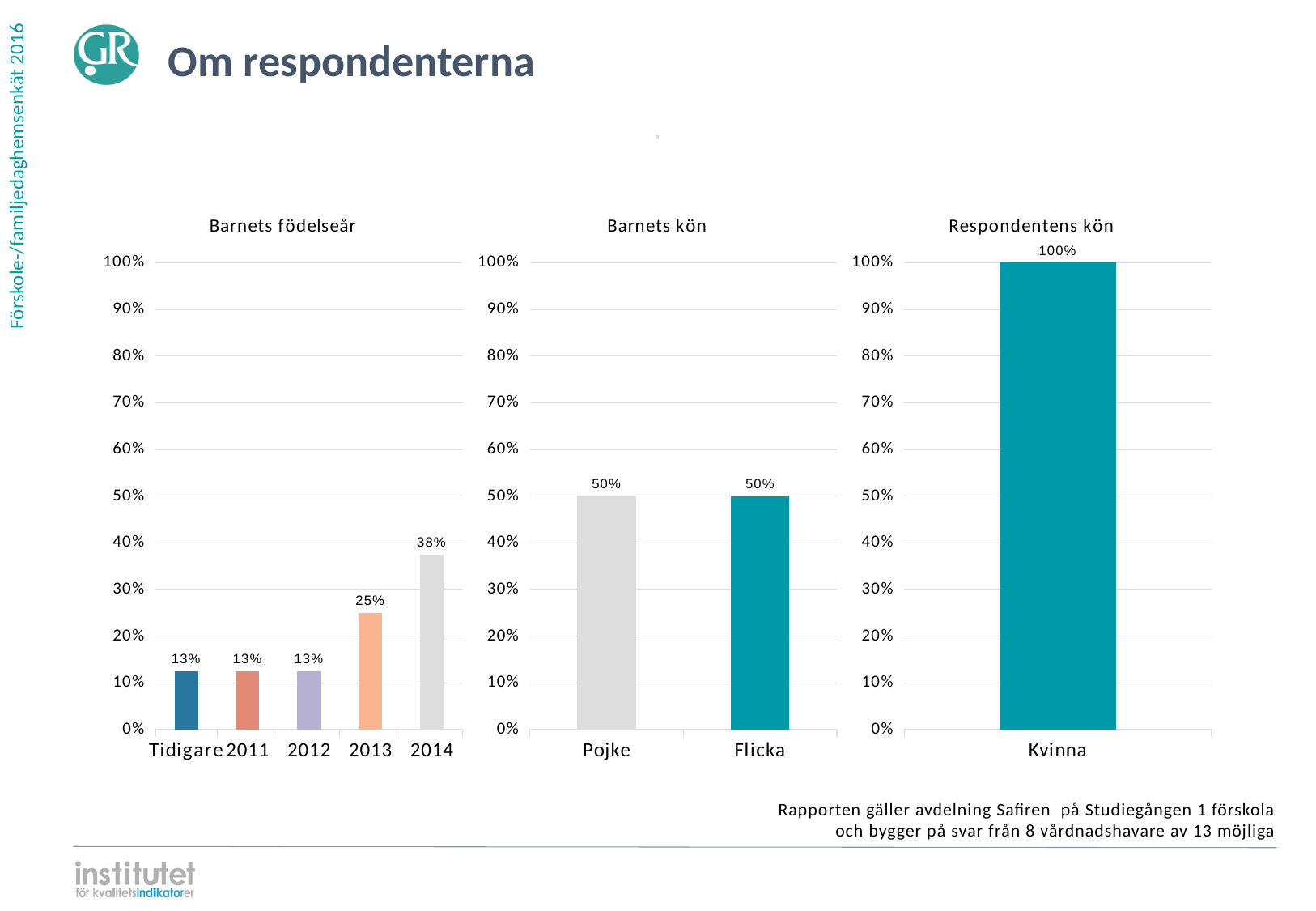
In the 'Barnets födelseår' chart, is the value for 2014 greater or less than 40%? less In the 'Barnets födelseår' chart, which category has the highest value? 2014 In the 'Barnets födelseår' chart, what is the value for 2014? 38% In the 'Barnets födelseår' chart, what is the difference between the values for 2014 and 2013? 13% What is the title of the chart on the left of the slide? Barnets födelseår In the 'Respondentens kön' chart, what is the value for Kvinna? 100% In the 'Barnets kön' chart, what is the difference between the values for Pojke and Flicka? 0% In the 'Barnets kön' chart, what is the value for Pojke? 50% In the 'Barnets födelseår' chart, how many categories are shown on the x axis? 5 What kind of chart is the 'Barnets kön' chart? bar chart In the 'Barnets födelseår' chart, what is the value for 2013? 25% In the 'Respondentens kön' chart, how many categories are shown on the x axis? 1